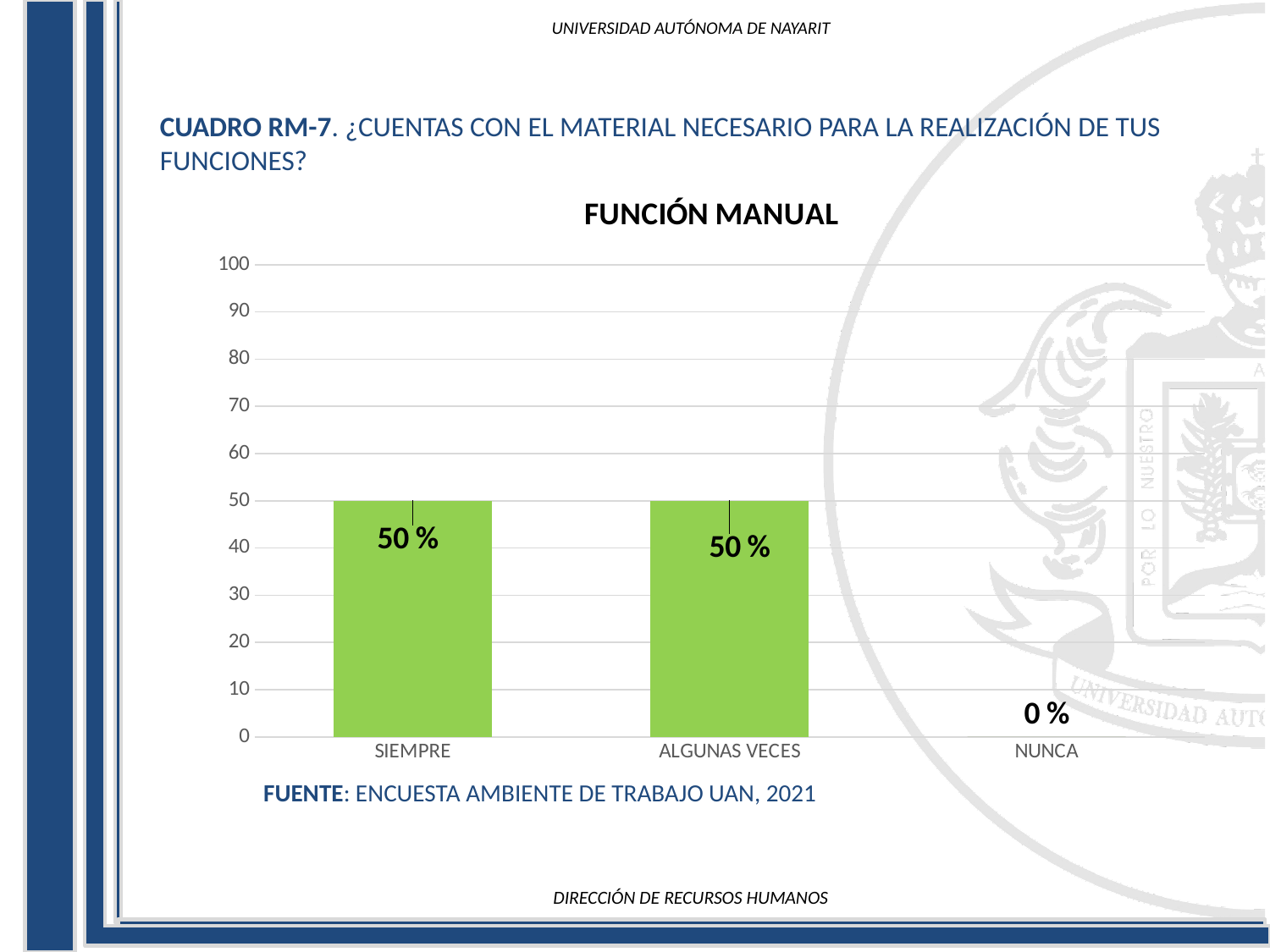
What is the highest value shown on the y axis? 100 What is the title of the chart? FUNCIÓN MANUAL What is the value for SIEMPRE? 50 % Which category has the lowest value? NUNCA What kind of chart is shown on the slide? bar chart Is the value for ALGUNAS VECES greater or less than 40? greater How many categories are shown on the x axis? 3 What is the difference between the values for SIEMPRE and NUNCA? 50 % What is the value for ALGUNAS VECES? 50 % What is the value for NUNCA? 0 % Is the value for SIEMPRE greater or less than 60? less Which is larger, the value for ALGUNAS VECES or the value for NUNCA? ALGUNAS VECES